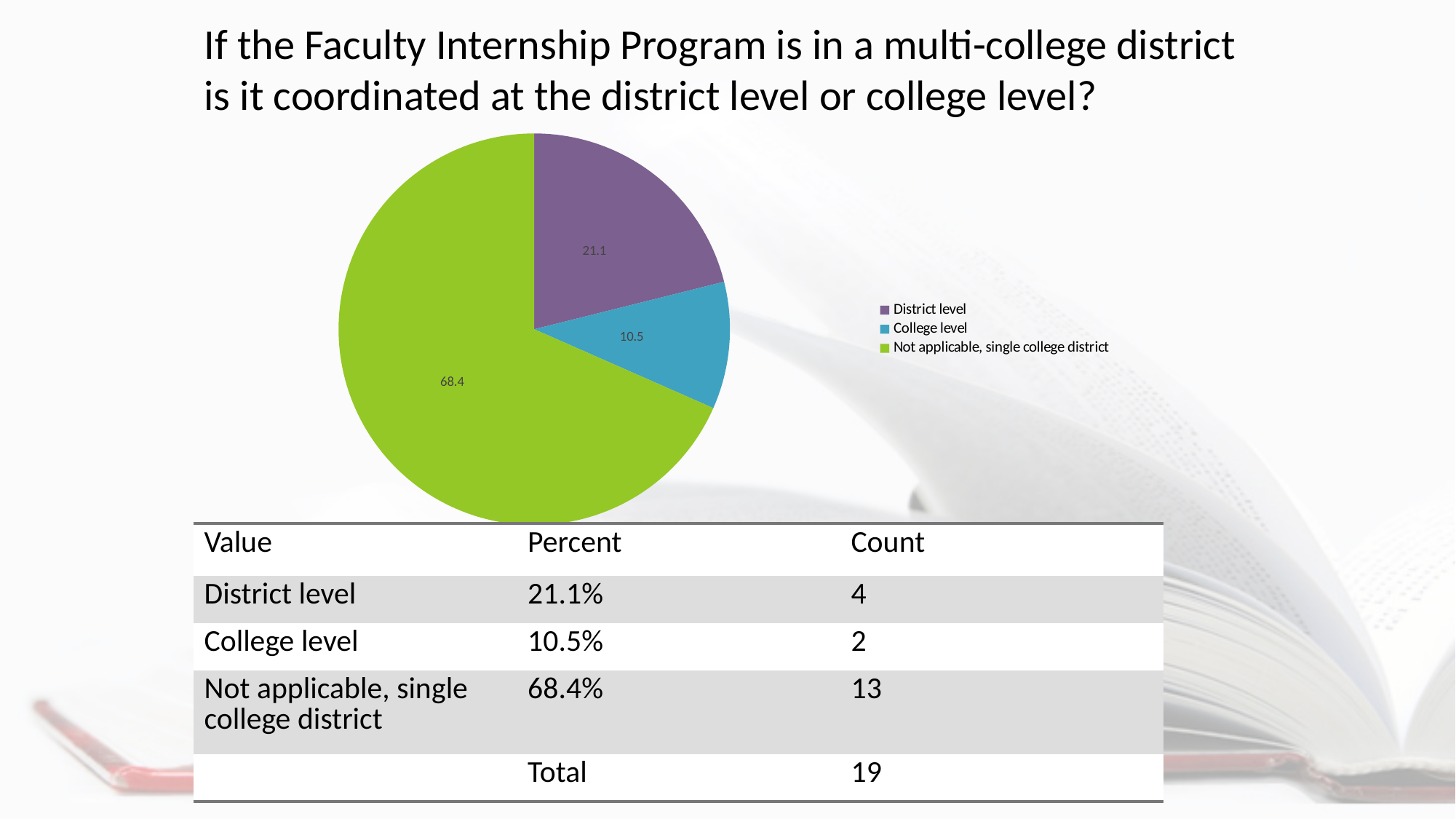
What kind of chart is shown on the slide? pie chart How many entries does the legend list? 3 What colour is the slice for Not applicable, single college district? green Which category has the largest slice of the pie? Not applicable, single college district How many slices does the pie chart have? 3 What value is shown on the pie slice for College level? 10.5 Which slice is larger, District level or College level? District level What is the difference between the District level and College level slice values? 10.6 What colour is the slice for District level? purple What value is shown on the pie slice for District level? 21.1 Which category has the smallest slice of the pie? College level What value is shown on the pie slice for Not applicable, single college district? 68.4